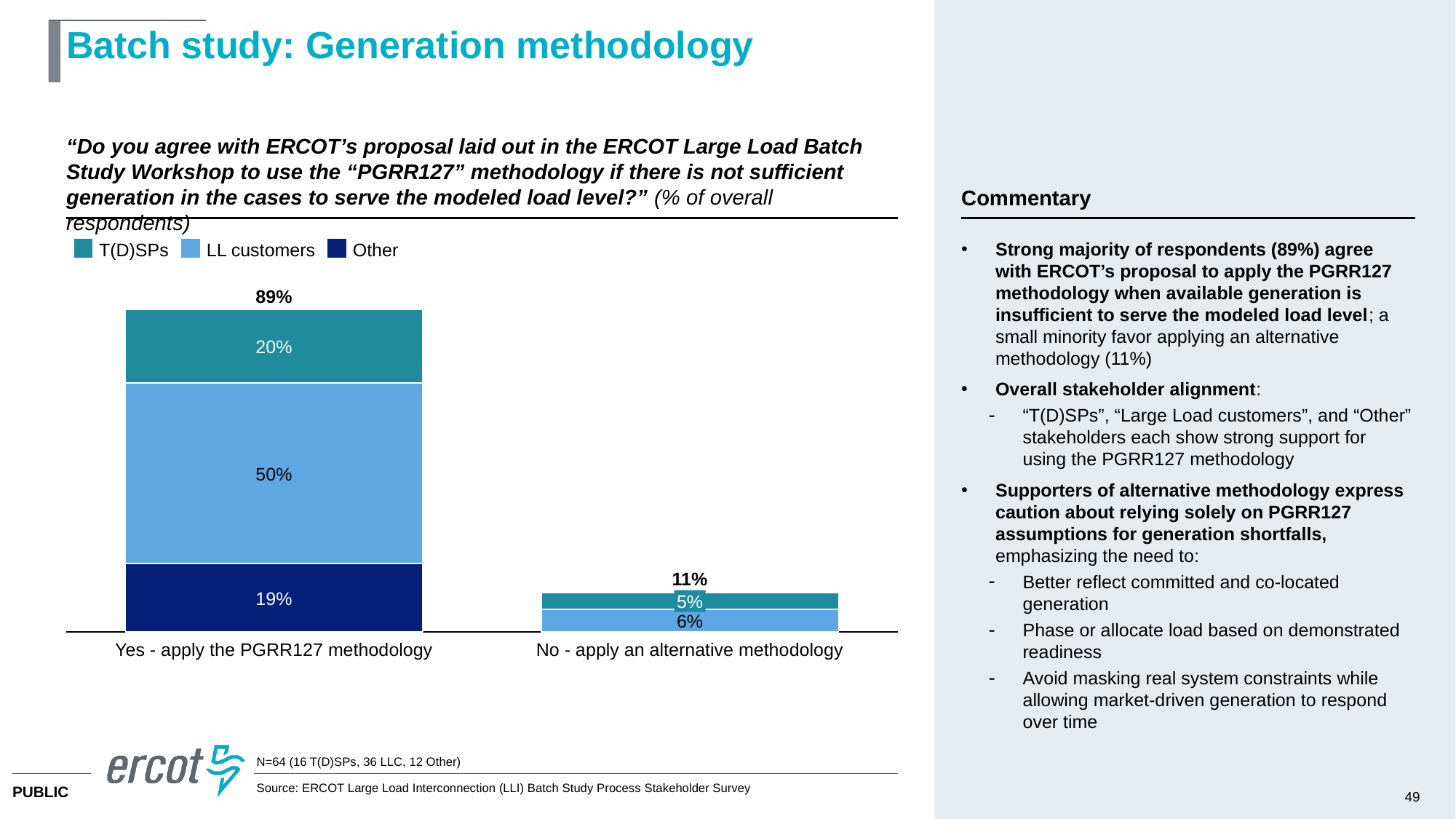
What kind of chart is shown on the slide? Stacked bar chart What is the Other value for "Yes - apply the PGRR127 methodology"? 19% What is the difference between the totals of the "Yes" and "No" bars? 78% What is the total for the "Yes - apply the PGRR127 methodology" bar? 89% What is the T(D)SPs value for "No - apply an alternative methodology"? 5% What is the difference between the T(D)SPs values for "Yes" and "No"? 15% Which response option has the highest total? Yes - apply the PGRR127 methodology What percentage of LL customers chose "Yes - apply the PGRR127 methodology"? 50% What is the total for the "No - apply an alternative methodology" bar? 11% How many series does the legend list? 3 Which is larger for "No - apply an alternative methodology": the T(D)SPs value or the LL customers value? LL customers How many response categories are shown on the x axis? 2